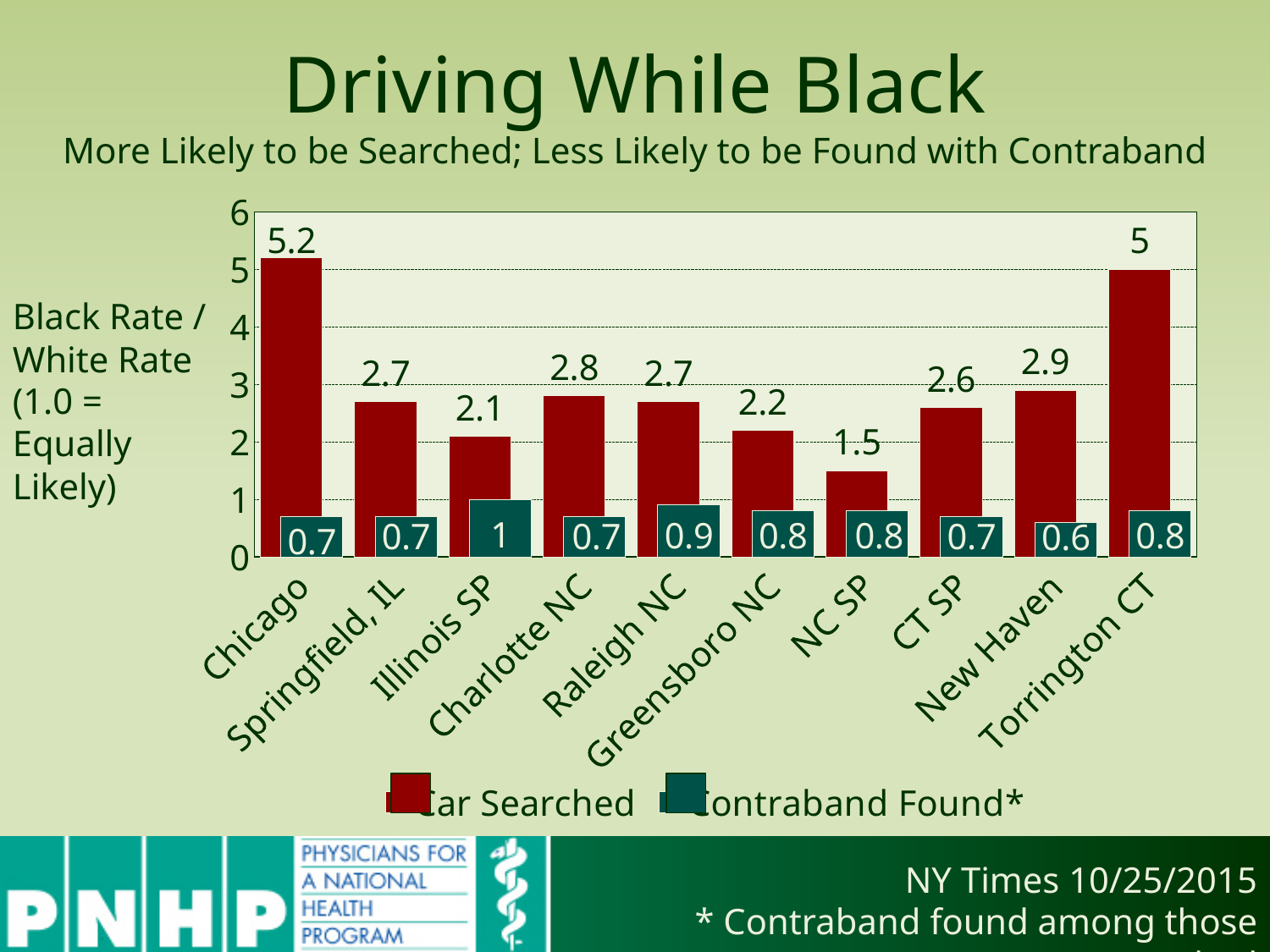
What is the Contraband Found* value for New Haven? 0.6 What is the title of the slide? Driving While Black Which category has the highest Car Searched value? Chicago Which category has the lowest Car Searched value? NC SP What is the Car Searched value for Torrington CT? 5 What is the difference between the Car Searched value and the Contraband Found* value for Chicago? 4.5 What is the Car Searched value for Chicago? 5.2 What kind of chart is shown on the slide? Bar chart How many categories are shown on the x axis? 10 How many series does the legend list? 2 What is the Contraband Found* value for Illinois SP? 1 Which is larger, the Car Searched value for New Haven or for CT SP? New Haven